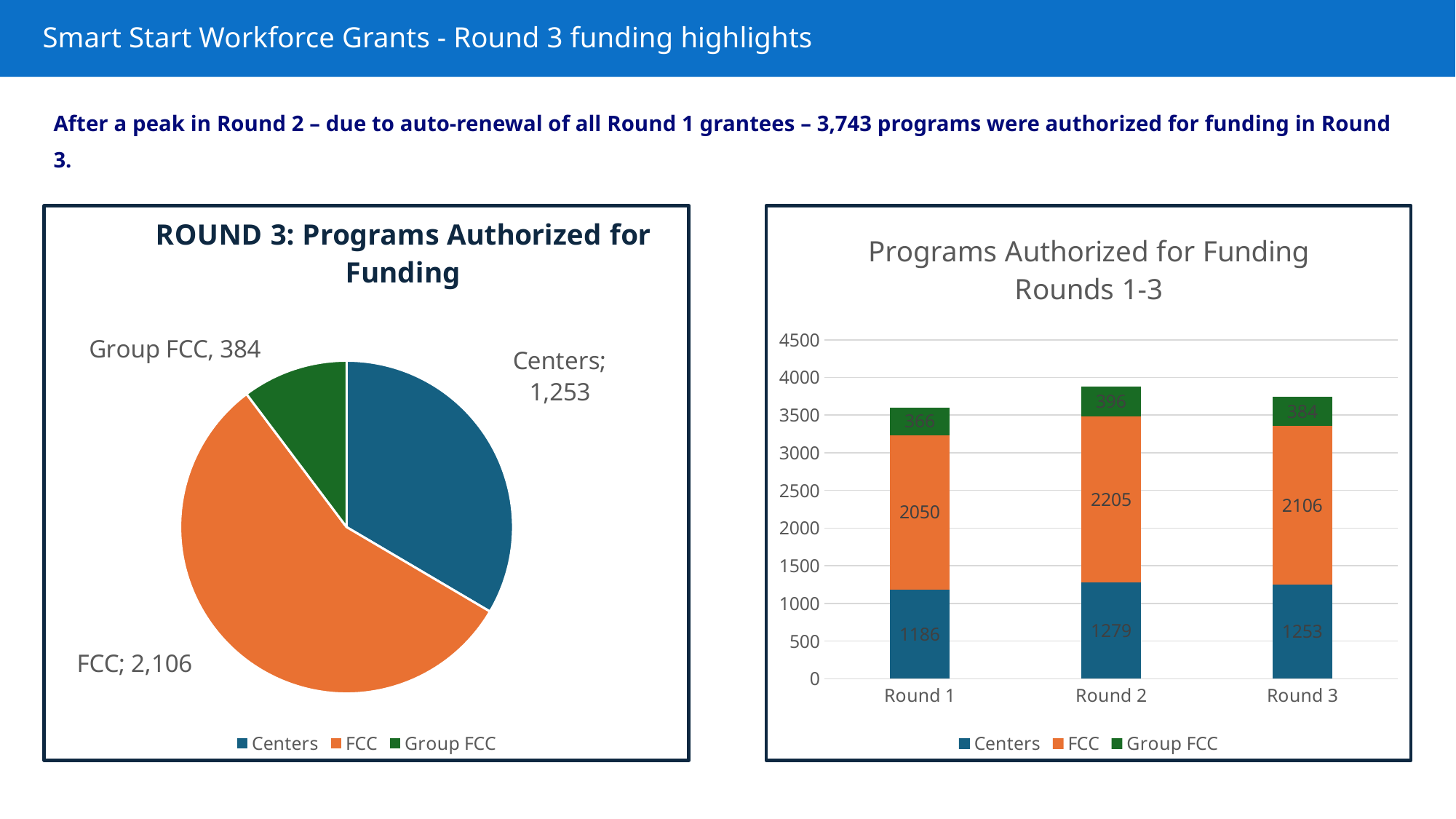
In the chart 'Programs Authorized for Funding Rounds 1-3', what is the total of the stacked bar for Round 2? 3880 In the pie chart 'ROUND 3: Programs Authorized for Funding', how many slices are there? 3 What kind of chart is 'Programs Authorized for Funding Rounds 1-3'? stacked bar chart In the pie chart 'ROUND 3: Programs Authorized for Funding', which category has the largest slice? FCC In the pie chart 'ROUND 3: Programs Authorized for Funding', which category has the smallest slice? Group FCC In the chart 'Programs Authorized for Funding Rounds 1-3', what is the Group FCC value for Round 1? 366 In the chart 'Programs Authorized for Funding Rounds 1-3', is the Centers value for Round 1 larger or smaller than the Centers value for Round 3? smaller In the pie chart 'ROUND 3: Programs Authorized for Funding', what is the value for FCC? 2,106 In the pie chart 'ROUND 3: Programs Authorized for Funding', what is the difference between the FCC and Centers values? 853 In the chart 'Programs Authorized for Funding Rounds 1-3', how many series does the legend list? 3 In the chart 'Programs Authorized for Funding Rounds 1-3', what is the FCC value for Round 2? 2205 In the chart 'Programs Authorized for Funding Rounds 1-3', which round has the highest Centers value? Round 2